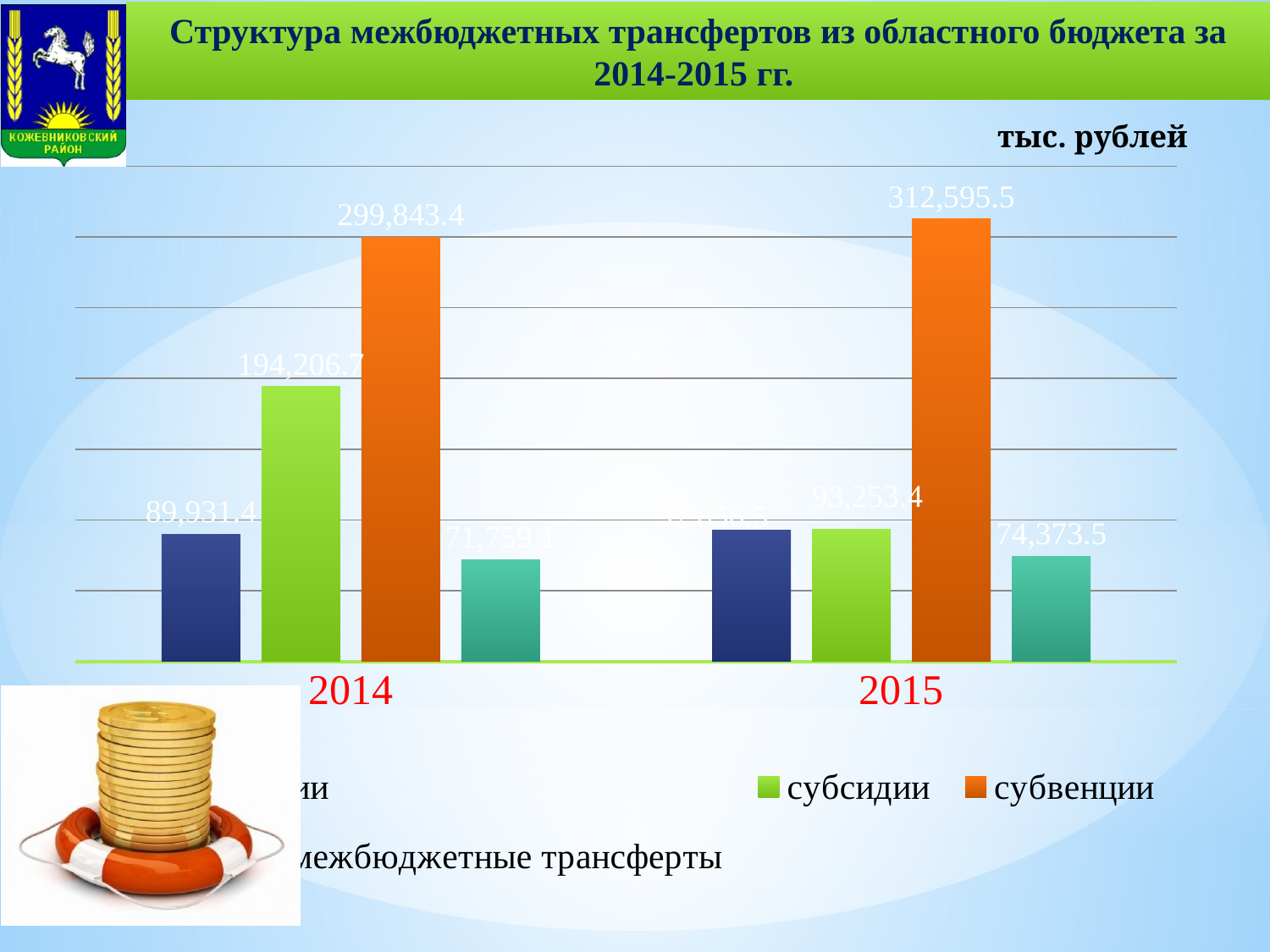
What is the difference between субсидии in 2014 and субсидии in 2015? 100,953.3 What type of chart is shown on the slide? bar chart What is the value of субсидии for 2014? 194,206.7 What is the value of субвенции for 2014? 299,843.4 Which year has the larger value for субсидии, 2014 or 2015? 2014 How many years are shown on the x axis? 2 Which year has the larger value for субвенции, 2014 or 2015? 2015 Which series has the highest value in 2015? субвенции In what units are the values on the chart given? тыс. рублей What is the value of субвенции for 2015? 312,595.5 By how much did субвенции increase from 2014 to 2015? 12,752.1 What is the value of субсидии for 2015? 93,253.4